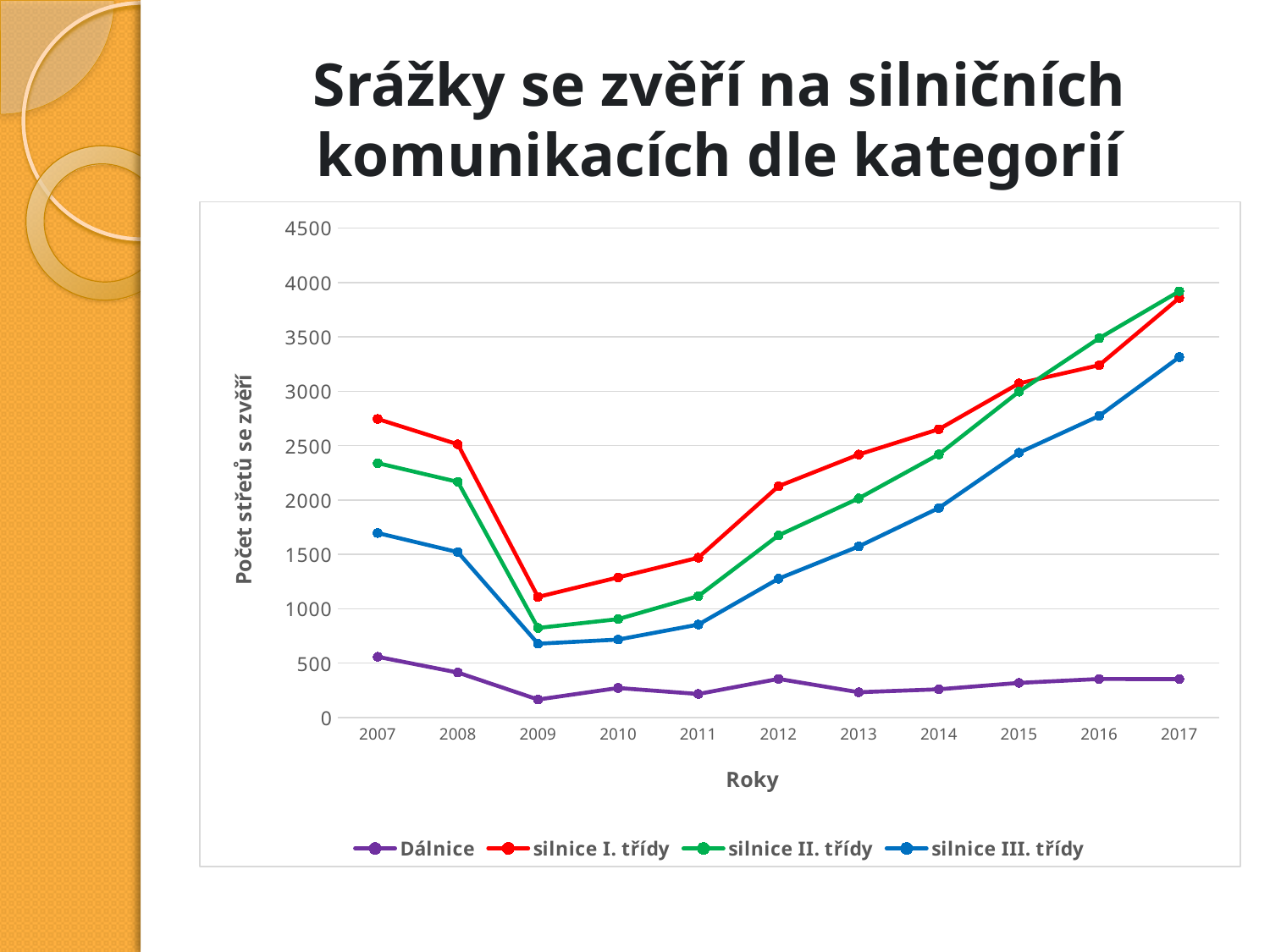
Do the values for silnice III. třídy rise or fall from 2011 to 2017? rise What is the title of the vertical axis? Počet střetů se zvěří How many series does the legend list? 4 In which year does the silnice I. třídy series reach its lowest value? 2009 How many years are plotted along the x axis? 11 Which series has the larger value in 2017, silnice II. třídy or silnice III. třídy? silnice II. třídy In which year does the silnice I. třídy series reach its highest value? 2017 What kind of chart is shown on the slide? line chart Is the value for Dálnice in 2009 greater or less than 500? less Is the value for silnice I. třídy in 2007 greater or less than 2500? greater In which year does the Dálnice series reach its lowest value? 2009 Is the value for silnice III. třídy in 2017 greater or less than 3000? greater